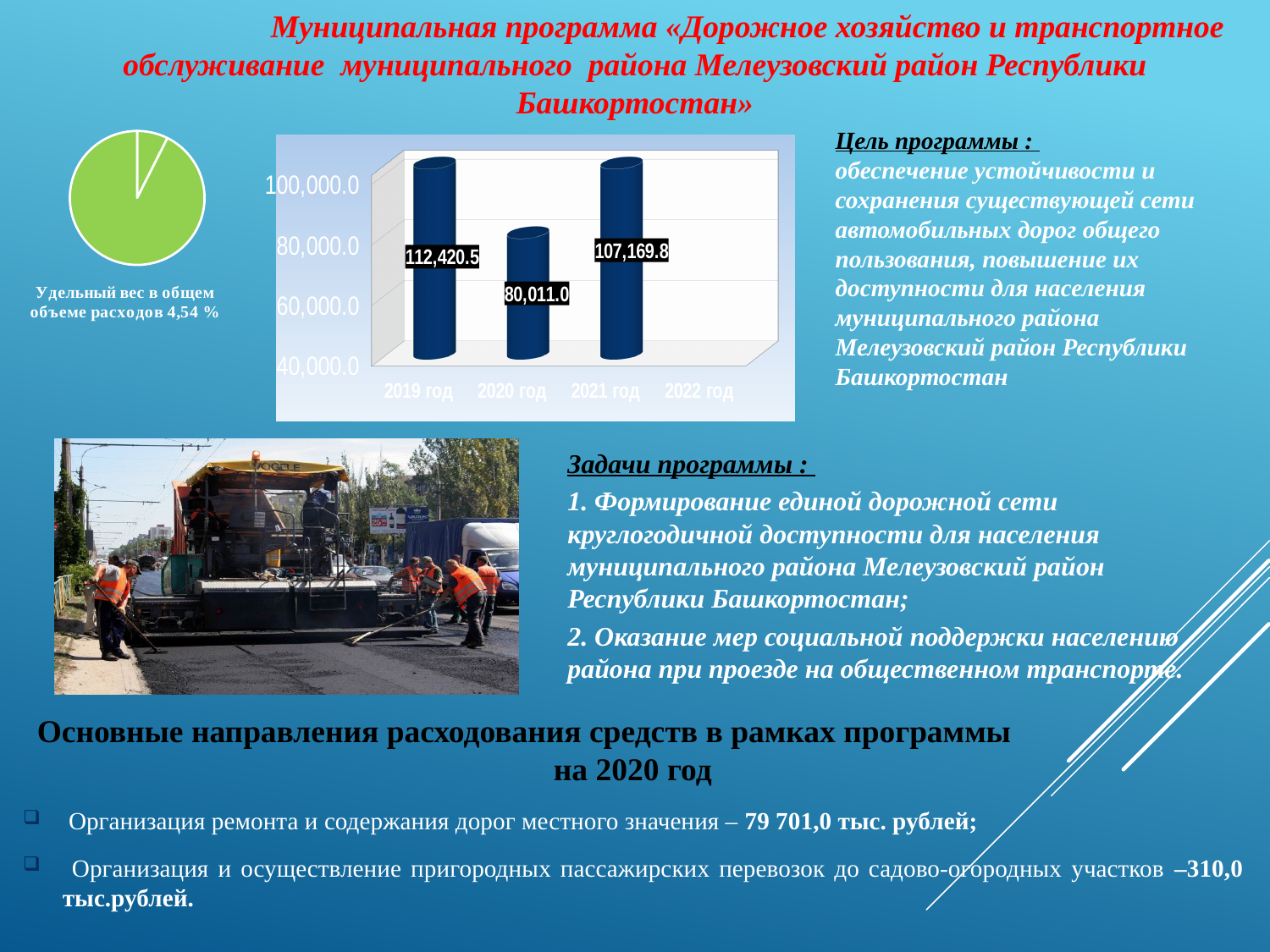
On the bar chart, what is the difference between the values for 2019 год and 2020 год? 32,409.5 On the bar chart, what is the value for 2019 год? 112,420.5 On the bar chart, what is the difference between the values for 2021 год and 2020 год? 27,158.8 According to the caption under the pie chart on the left, what share of total expenditure does the small slice represent? 4,54 % On the bar chart, which year has the lowest value among the plotted bars? 2020 год On the bar chart, which year has the highest value? 2019 год On the bar chart, is the value for 2020 год greater or less than 100,000.0? less On the bar chart, which is larger, the value for 2019 год or 2021 год? 2019 год What kind of chart is the large chart in the top centre of the slide? bar chart On the bar chart, what is the value for 2020 год? 80,011.0 On the bar chart, how many bars with data labels are plotted? 3 On the bar chart, what is the value for 2021 год? 107,169.8